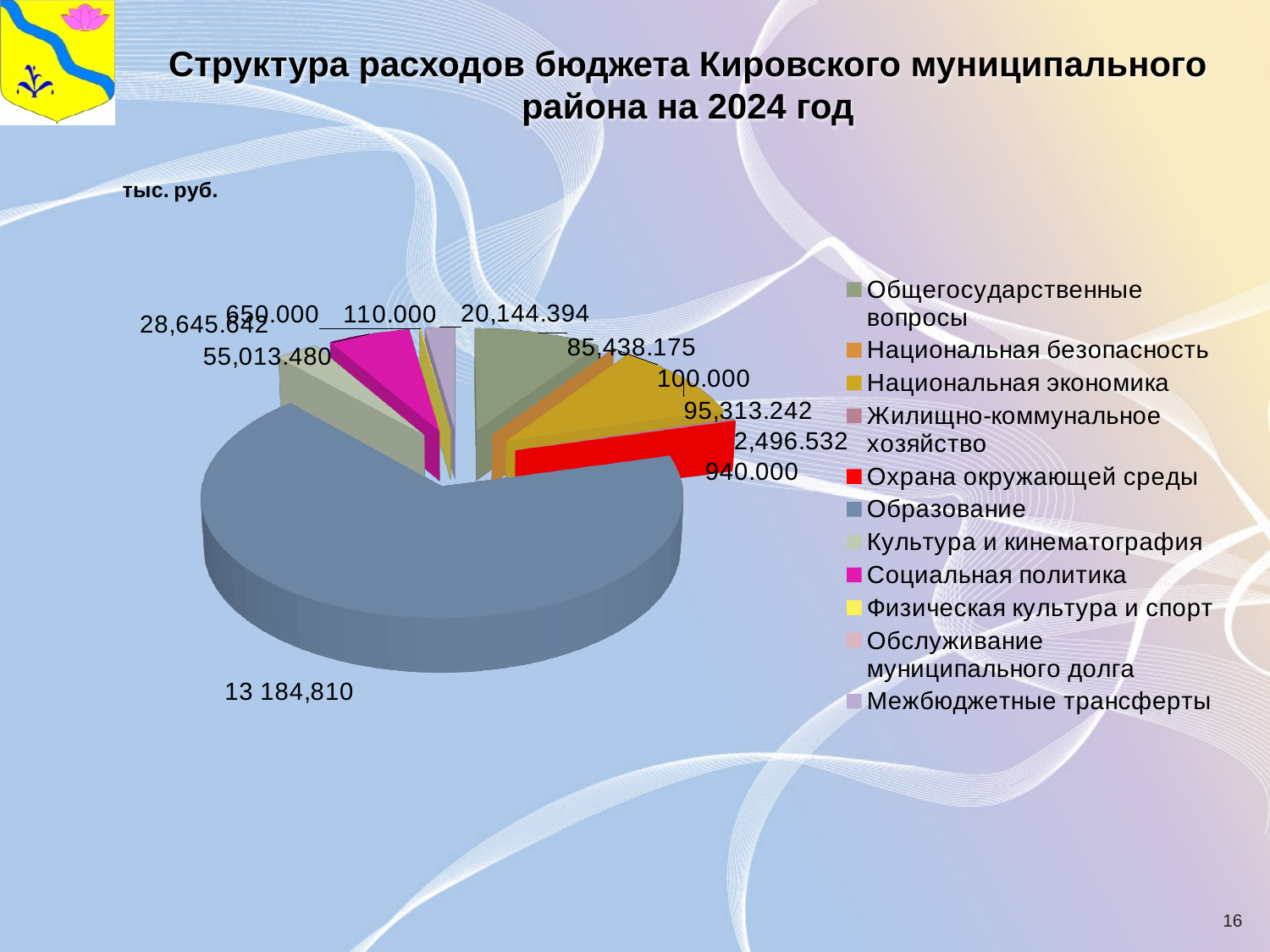
What kind of chart is shown on the slide? pie chart Which category has the largest slice in the pie chart? Образование Which is larger, the slice for Образование or the slice for Социальная политика? Образование Which is larger, the slice for Образование or the slice for Общегосударственные вопросы? Образование How many categories does the legend of the pie chart list? 11 What value is labelled for the Образование slice? 13 184,810 In what units are the values of the chart given, according to the label above it? тыс. руб. What colour is the Охрана окружающей среды slice in the pie chart? red